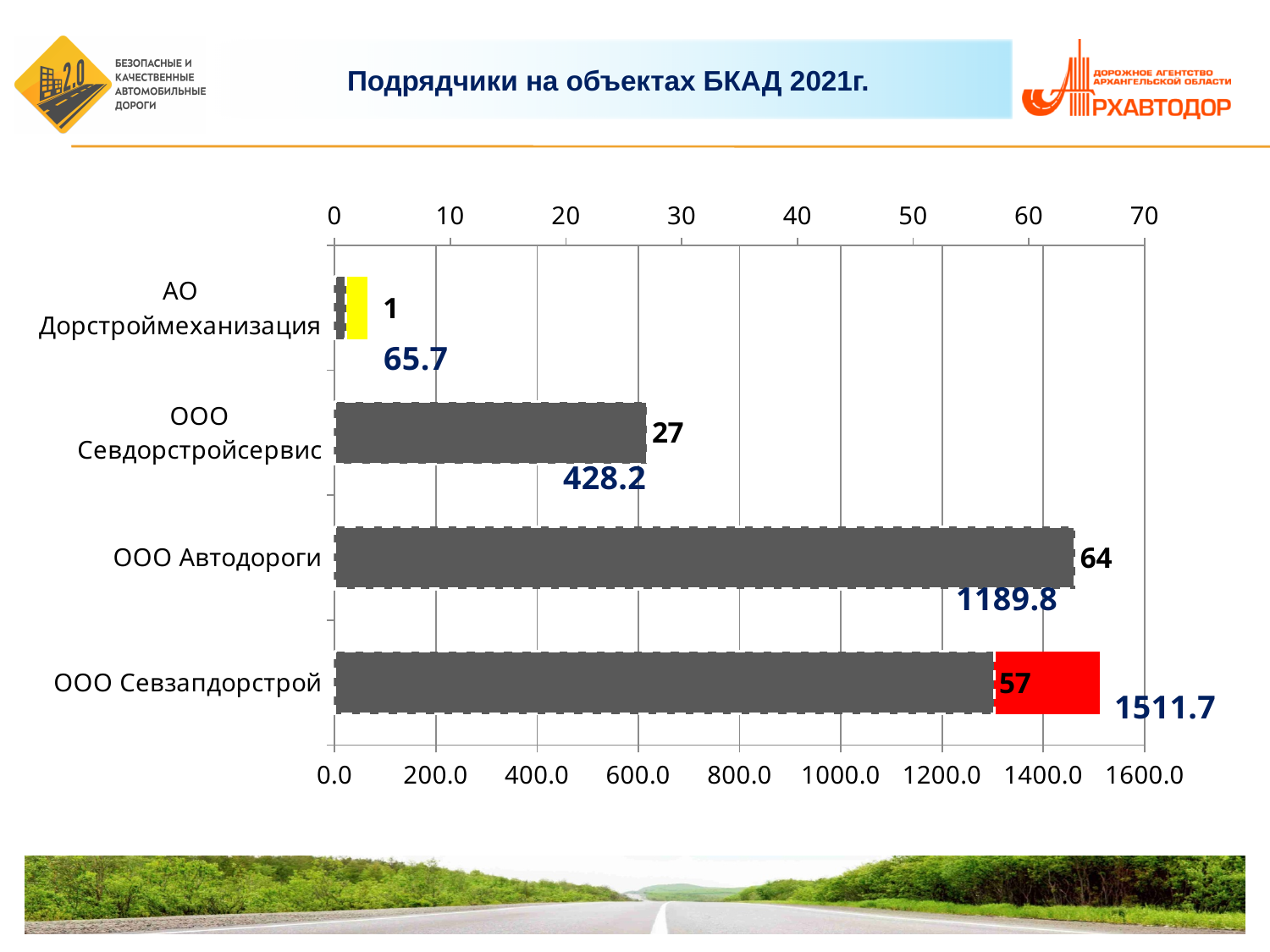
What kind of chart is shown on the slide? bar chart What is the difference between the blue-labelled values of ООО Севзапдорстрой and ООО Автодороги? 321.9 Which contractor has the lowest blue-labelled value? АО Дорстроймеханизация What is the blue-labelled value for ООО Севдорстройсервис? 428.2 Which contractor has the highest black-labelled value? ООО Автодороги What is the black-labelled value for АО Дорстроймеханизация? 1 What is the black-labelled value for ООО Автодороги? 64 What is the title of the chart on the slide? Подрядчики на объектах БКАД 2021г. How many contractors (categories) are shown in the chart? 4 Which contractor has the highest blue-labelled value? ООО Севзапдорстрой What is the blue-labelled value for ООО Севзапдорстрой? 1511.7 What is the difference between the black-labelled values of ООО Автодороги and ООО Севзапдорстрой? 7